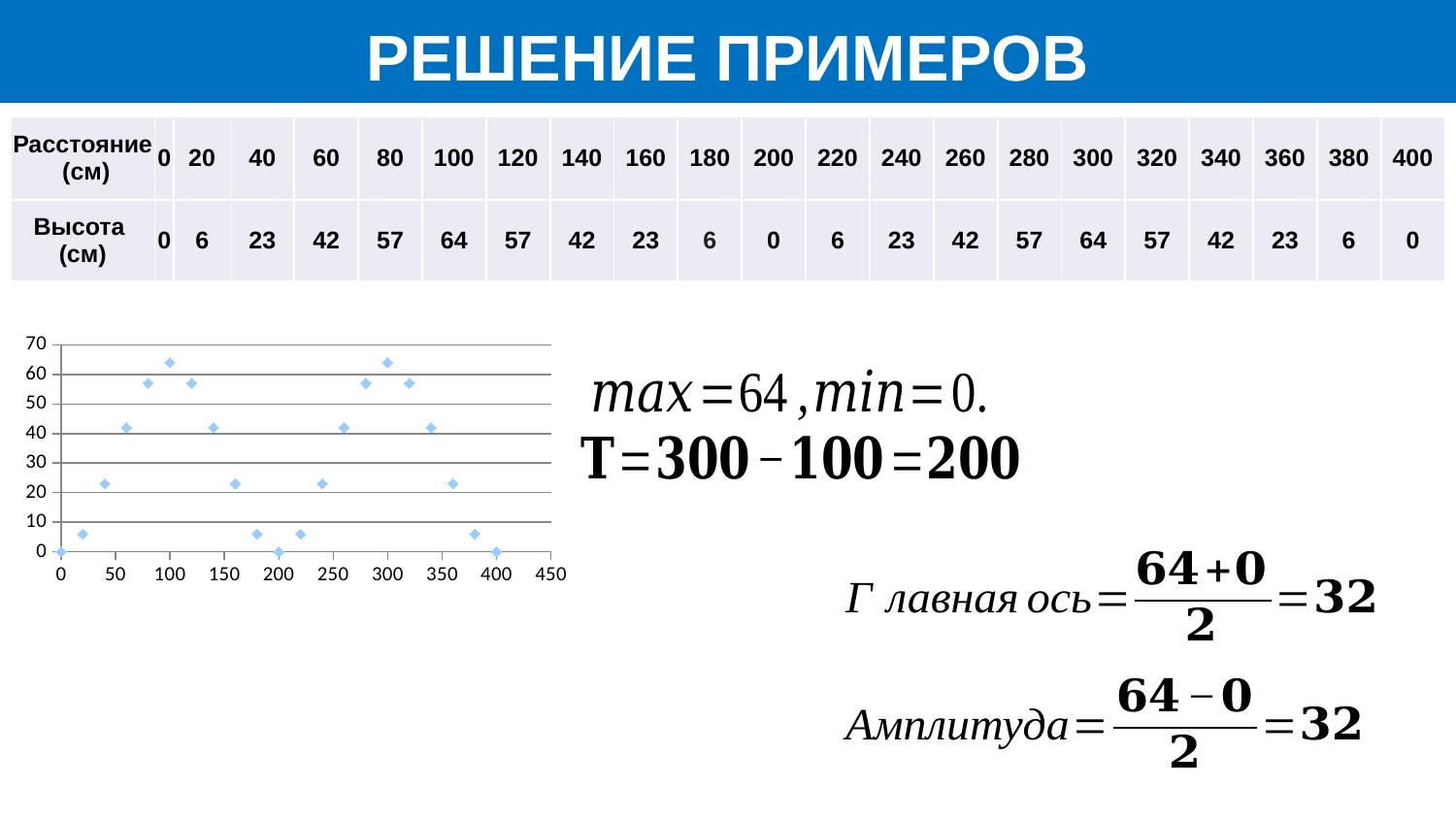
What is the maximum value shown on the vertical axis of the chart? 70 Is the height at a distance of 380 cm greater or less than 10? less What is the height (Высота) at a distance of 40 cm? 23 What is the height (Высота) at a distance of 280 cm? 57 Which is larger: the height at 60 cm or the height at 180 cm? 60 cm What is the height (Высота) at a distance of 100 cm? 64 How many data points are plotted on the chart? 21 What is the highest height value plotted on the chart? 64 What kind of chart is shown on the slide? scatter chart What is the lowest height value plotted on the chart? 0 What is the difference between the height at 100 cm and the height at 20 cm? 58 Is the height at a distance of 300 cm greater or less than 60? greater